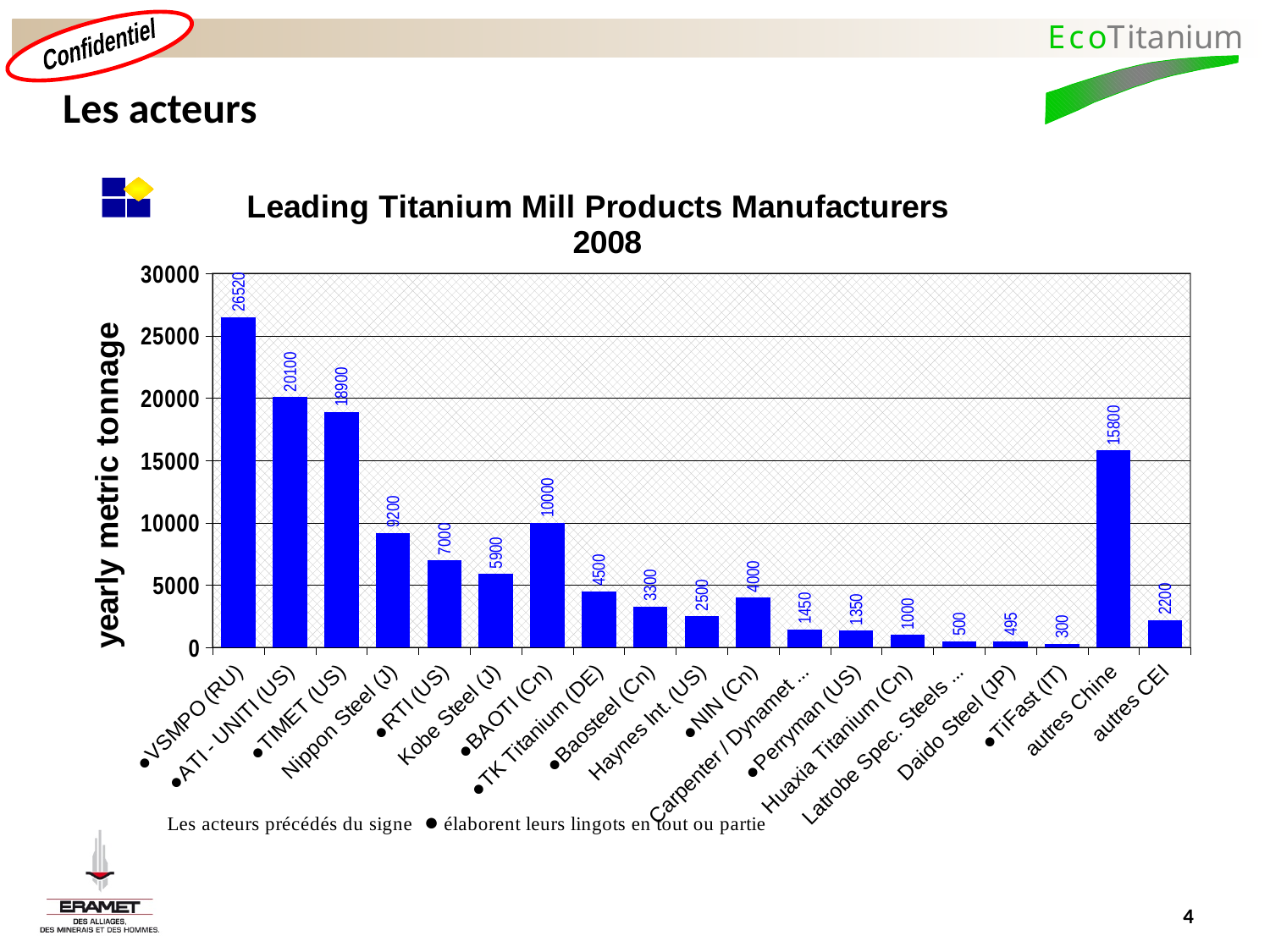
What is the yearly metric tonnage for autres Chine? 15800 Which manufacturer has the lowest yearly metric tonnage? TiFast (IT) What kind of chart is shown on the slide? Bar chart What is the label of the y axis? yearly metric tonnage What is the yearly metric tonnage for BAOTI (Cn)? 10000 What is the yearly metric tonnage for VSMPO (RU)? 26520 What is the yearly metric tonnage for Daido Steel (JP)? 495 What is the difference in yearly metric tonnage between ATI - UNITI (US) and TIMET (US)? 1200 How many manufacturers (categories) are shown on the x axis? 19 Which has a larger yearly metric tonnage, Nippon Steel (J) or RTI (US)? Nippon Steel (J) Is the value for Kobe Steel (J) greater or less than 5000? greater Which manufacturer has the highest yearly metric tonnage? VSMPO (RU)